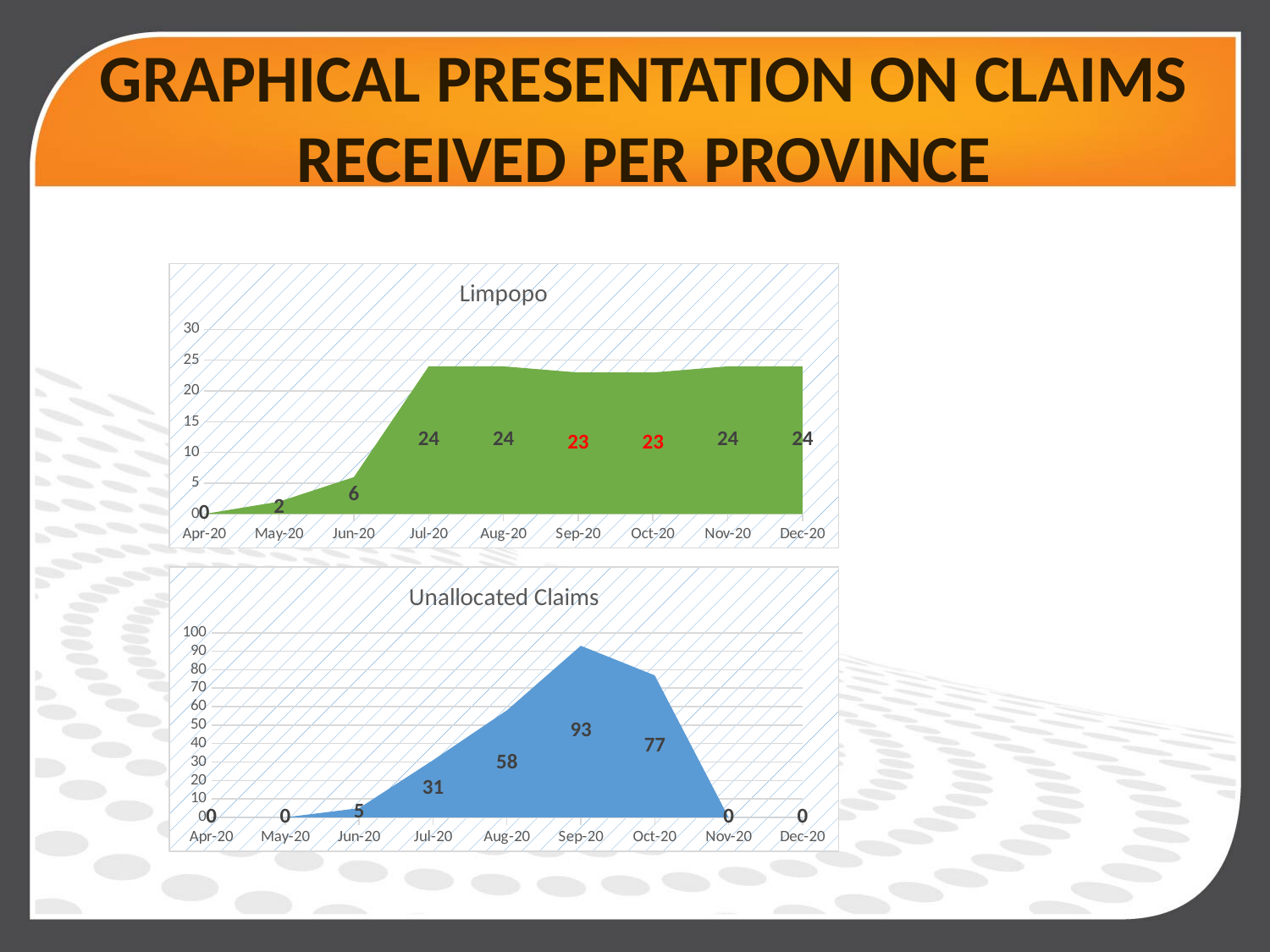
In the Unallocated Claims chart, what is the value for Oct-20? 77 In the Unallocated Claims chart, do the values rise or fall from Jun-20 to Sep-20? Rise In the Limpopo chart, what is the value for Sep-20? 23 In the Limpopo chart, which month has the lowest value? Apr-20 In the Unallocated Claims chart, which is larger, the value for Jul-20 or the value for Aug-20? Aug-20 In the Unallocated Claims chart, which month has the highest value? Sep-20 In the Unallocated Claims chart, what is the difference between the values for Sep-20 and Oct-20? 16 In the Limpopo chart, what is the value for Jun-20? 6 In the Limpopo chart, what is the difference between the values for Jul-20 and Jun-20? 18 In the Unallocated Claims chart, what is the value for Aug-20? 58 What kind of chart is the Unallocated Claims chart? Area chart How many months are plotted on the x axis of the Limpopo chart? 9